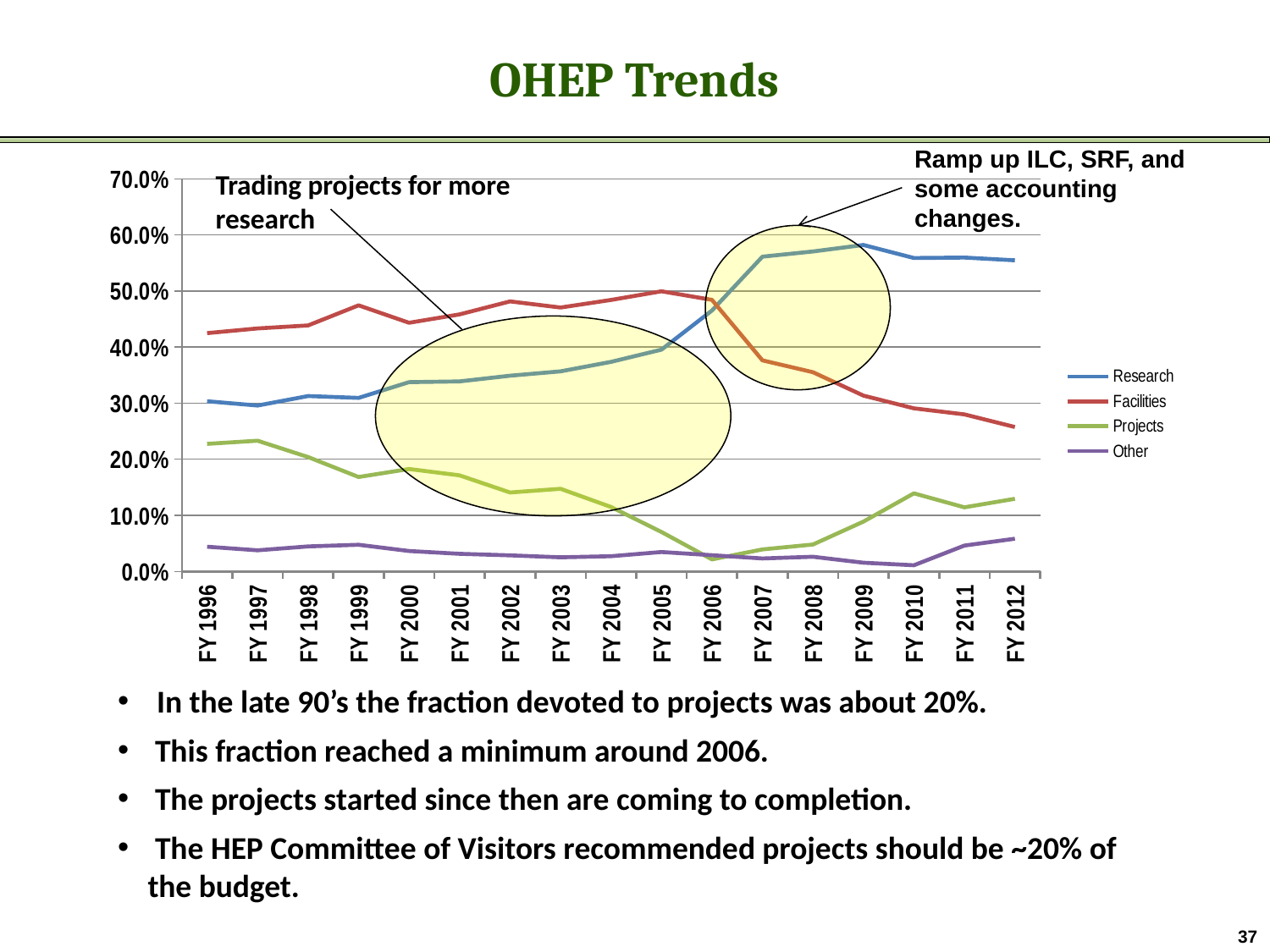
Is the value for Facilities in FY 1996 greater or less than 40%? greater In FY 2010, which is larger: Research or Facilities? Research In FY 2000, which is larger: Facilities or Research? Facilities Is the value for Research in FY 2012 greater or less than 50%? greater How many fiscal years are plotted along the x axis? 17 How many series does the legend list? 4 Does the Research line rise or fall from FY 2005 to FY 2009? rise Does the Facilities line rise or fall from FY 2006 to FY 2012? fall What kind of chart is shown on the slide? line chart Is the value for Projects in FY 2006 greater or less than 10%? less Which series is drawn in red? Facilities Which series has the highest value in FY 2012? Research